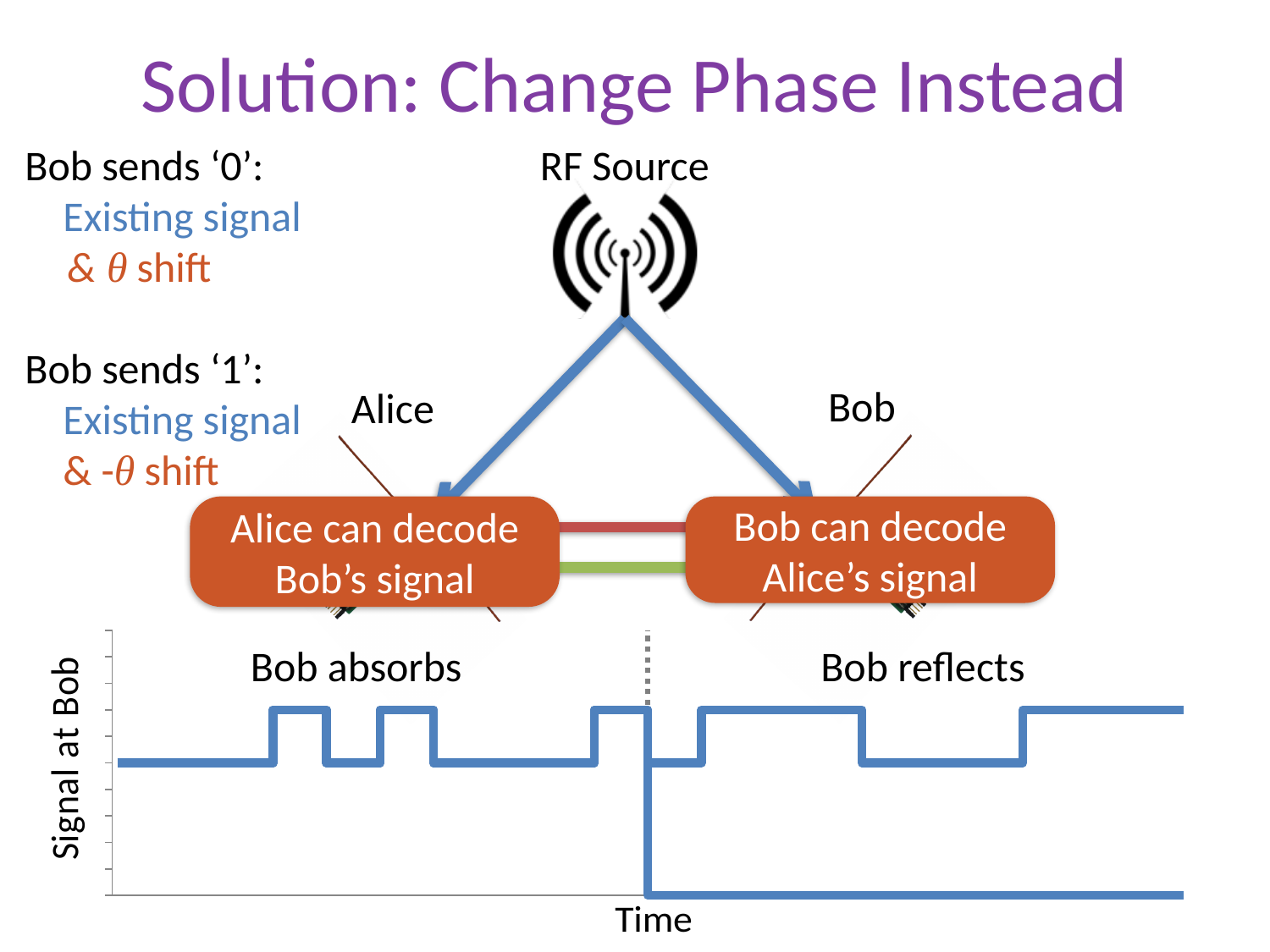
What is the label on the vertical axis of the chart? Signal at Bob Does the signal at Bob reach a lower level in the 'Bob reflects' region than anywhere in the 'Bob absorbs' region? yes What kind of chart is shown at the bottom of the slide? line chart At the dotted vertical line, does the plotted signal at Bob rise or fall? fall Is the lowest level of the signal reached in the 'Bob absorbs' region or the 'Bob reflects' region? Bob reflects What is the label on the horizontal axis of the chart? Time